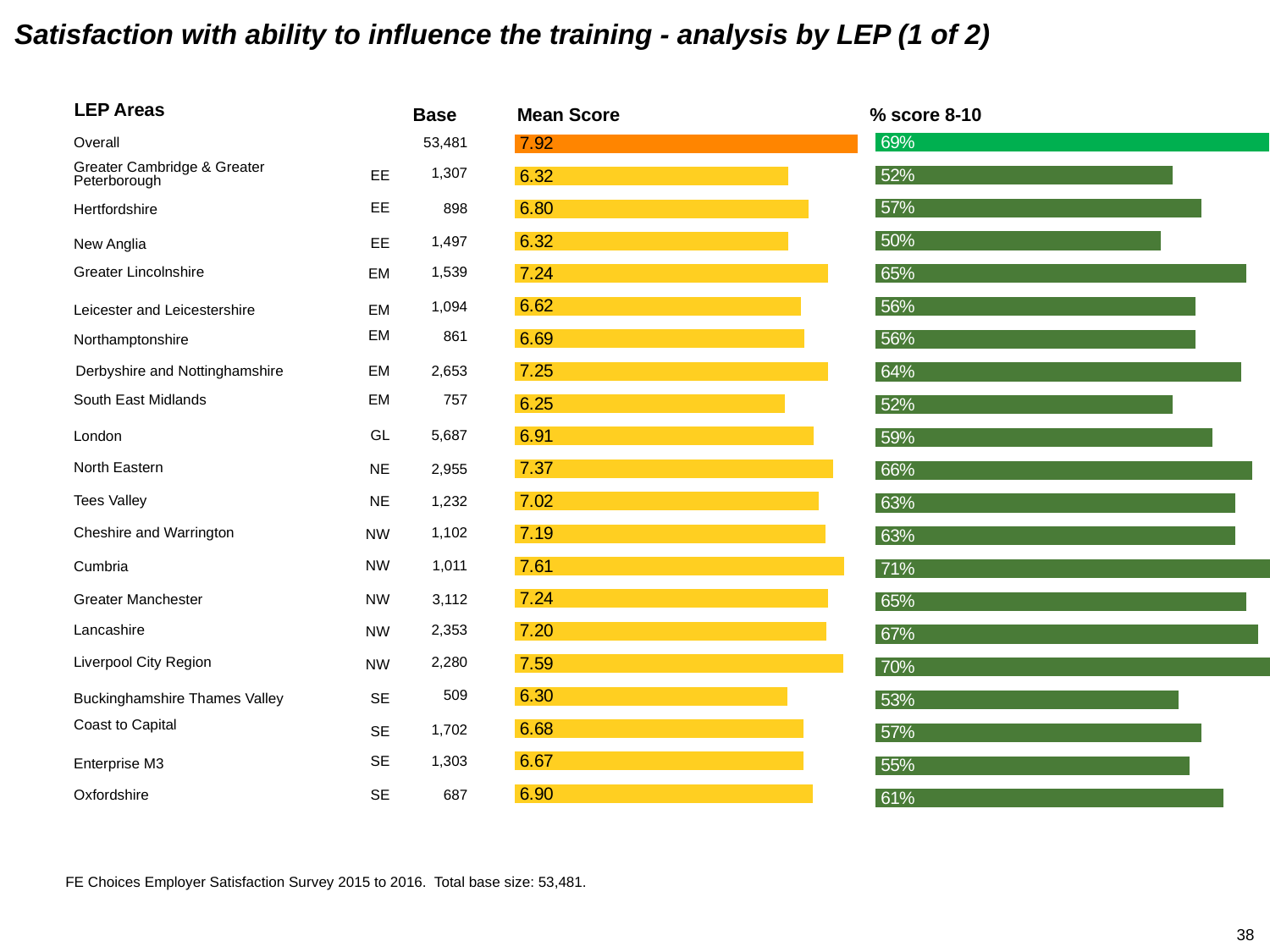
In the % score 8-10 chart, what is the value for Liverpool City Region? 70% In the % score 8-10 chart, which LEP area (excluding Overall) has the highest value? Cumbria In the % score 8-10 chart, what is the difference between Lancashire and Hertfordshire? 10% In the Mean Score chart, which has the higher mean score, North Eastern or London? North Eastern In the % score 8-10 chart, which is higher, Greater Lincolnshire or Tees Valley? Greater Lincolnshire In the Mean Score chart, what is the Overall mean score? 7.92 In the Mean Score chart, which LEP area (excluding Overall) has the lowest mean score? South East Midlands What type of chart is used to show the Mean Score? Bar chart In the Mean Score chart, what is the mean score for Cumbria? 7.61 In the % score 8-10 chart, which LEP area has the lowest value? New Anglia How many LEP areas (excluding the Overall row) are shown in the Mean Score chart? 20 In the Mean Score chart, what is the difference between the mean scores for Cumbria and South East Midlands? 1.36